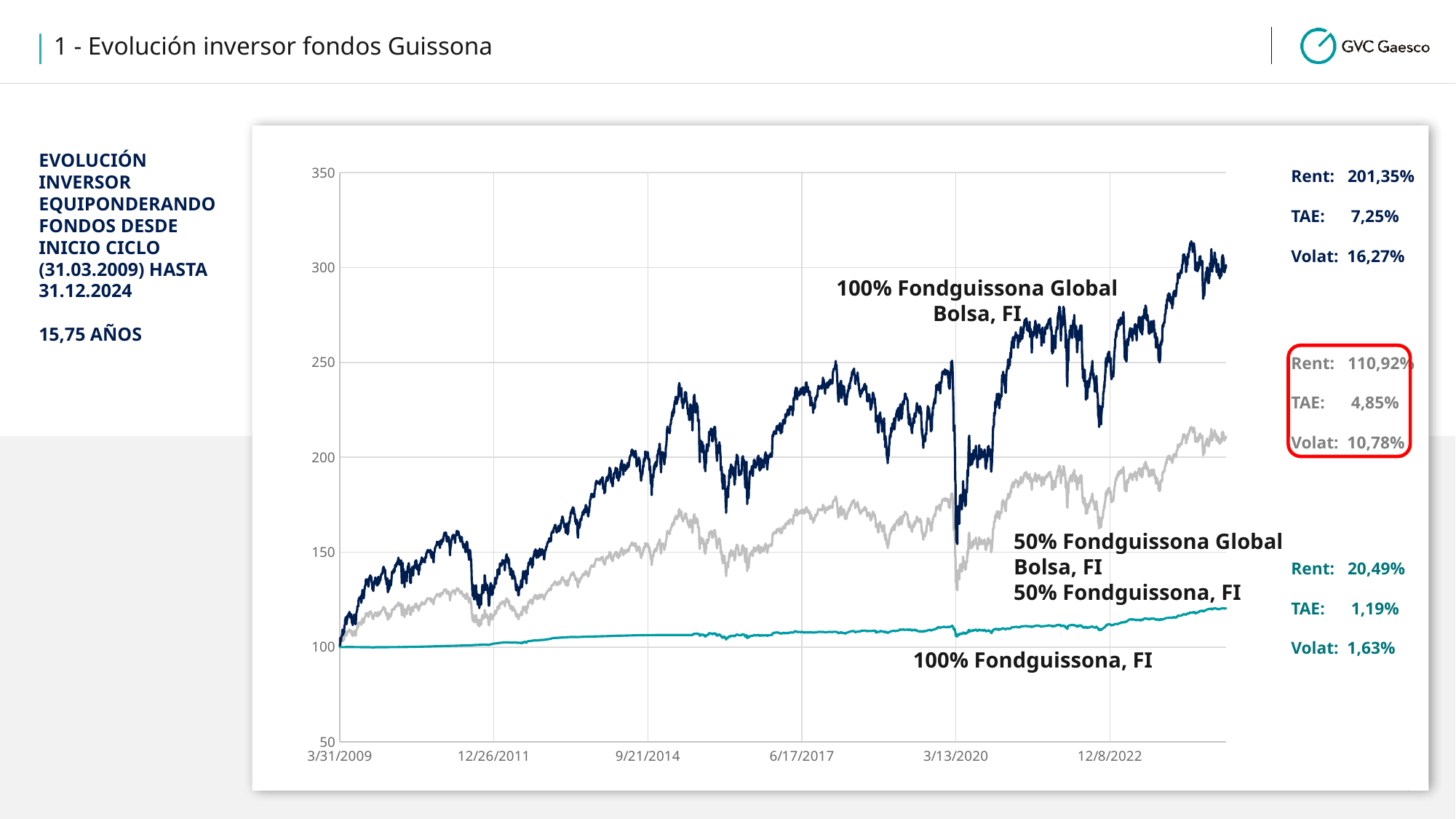
Is the value of the 100% Fondguissona Global Bolsa, FI line at the end of the period greater or less than 250? greater How many series (lines) are plotted on the chart? 3 What kind of chart is shown on the slide? Line chart What is the TAE value shown for the 50% Fondguissona Global Bolsa, FI / 50% Fondguissona, FI combination? 4,85% Is the value of the 100% Fondguissona, FI line at the end of the period greater or less than 150? less What is the Rent value shown for 100% Fondguissona Global Bolsa, FI? 201,35% What is the Volat value shown for 100% Fondguissona, FI? 1,63% Which series has the highest Rent value? 100% Fondguissona Global Bolsa, FI Which series has the lowest Volat value? 100% Fondguissona, FI Which is larger: the Volat of 100% Fondguissona Global Bolsa, FI or the Volat of the 50%/50% combination? 100% Fondguissona Global Bolsa, FI What is the difference between the TAE of 100% Fondguissona Global Bolsa, FI and the TAE of the 50%/50% combination? 2,40% Which series' statistics are highlighted with a red box? 50% Fondguissona Global Bolsa, FI / 50% Fondguissona, FI